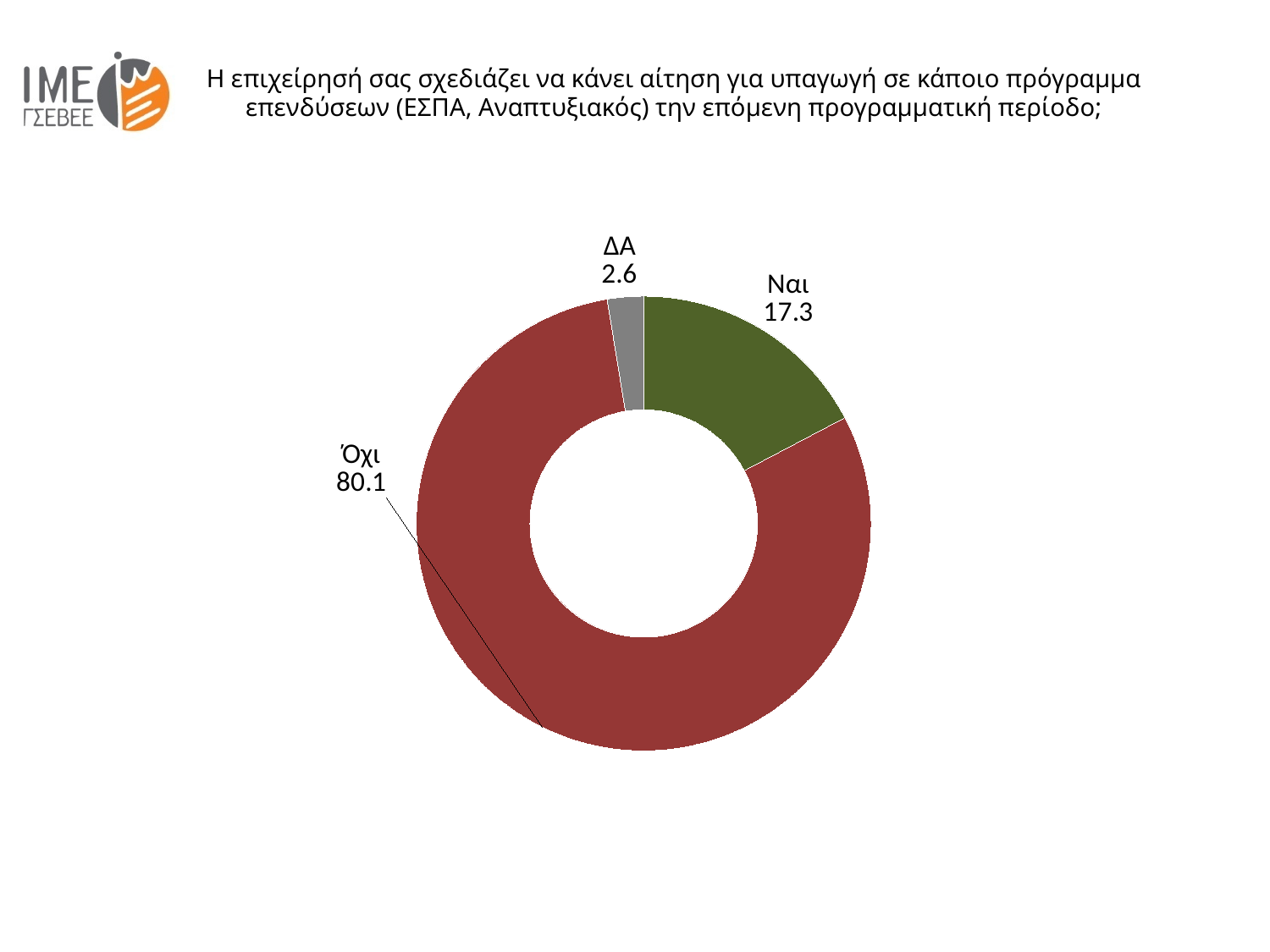
Which category has the largest slice? Όχι How many categories are shown in the chart? 3 What value is shown for the Όχι slice? 80.1 Which is larger, the value for Ναι or the value for ΔΑ? Ναι What value is shown for the Ναι slice? 17.3 What value is shown for the ΔΑ slice? 2.6 What kind of chart is shown on the slide? Doughnut (pie) chart Which category has the smallest slice? ΔΑ What colour is the Ναι slice? Green What is the difference between the values for Όχι and Ναι? 62.8 What is the difference between the values for Ναι and ΔΑ? 14.7 What is the total of the three values shown in the chart? 100